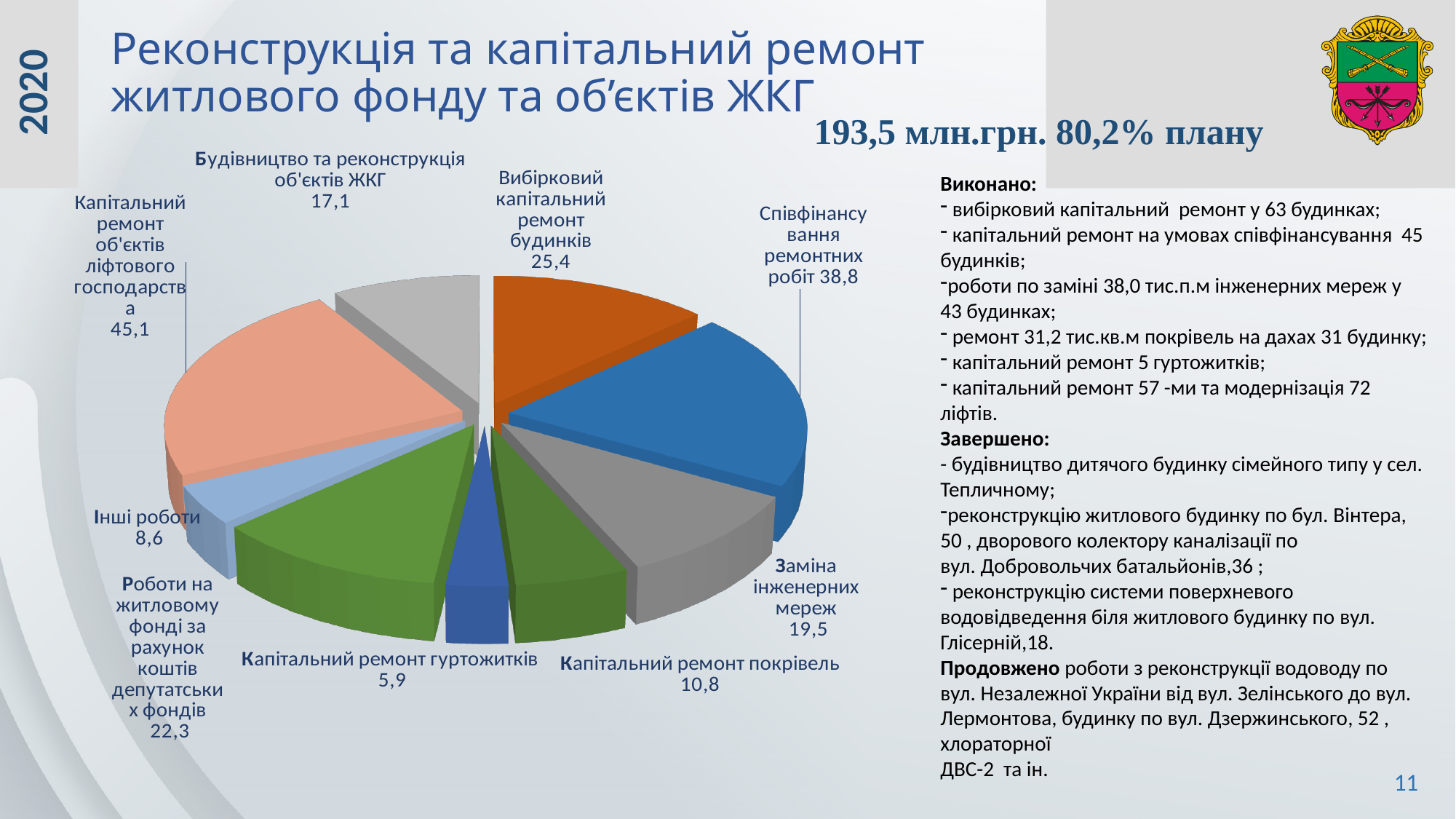
What is the difference between the values for "Капітальний ремонт об'єктів ліфтового господарства" and "Співфінансування ремонтних робіт"? 6,3 What is the difference between the values for "Заміна інженерних мереж" and "Капітальний ремонт гуртожитків"? 13,6 What is the value for "Будівництво та реконструкція об'єктів ЖКГ"? 17,1 Which category has the smallest value in the pie chart? Капітальний ремонт гуртожитків How many slices does the pie chart have? 9 What is the value for "Співфінансування ремонтних робіт"? 38,8 What kind of chart is shown on the slide? Pie chart Which is larger: "Вибірковий капітальний ремонт будинків" or "Роботи на житловому фонді за рахунок коштів депутатських фондів"? Вибірковий капітальний ремонт будинків What total amount in million UAH is stated above the chart? 193,5 млн.грн. What is the value for "Інші роботи"? 8,6 What is the value for "Капітальний ремонт покрівель"? 10,8 Which category has the largest value in the pie chart? Капітальний ремонт об'єктів ліфтового господарства